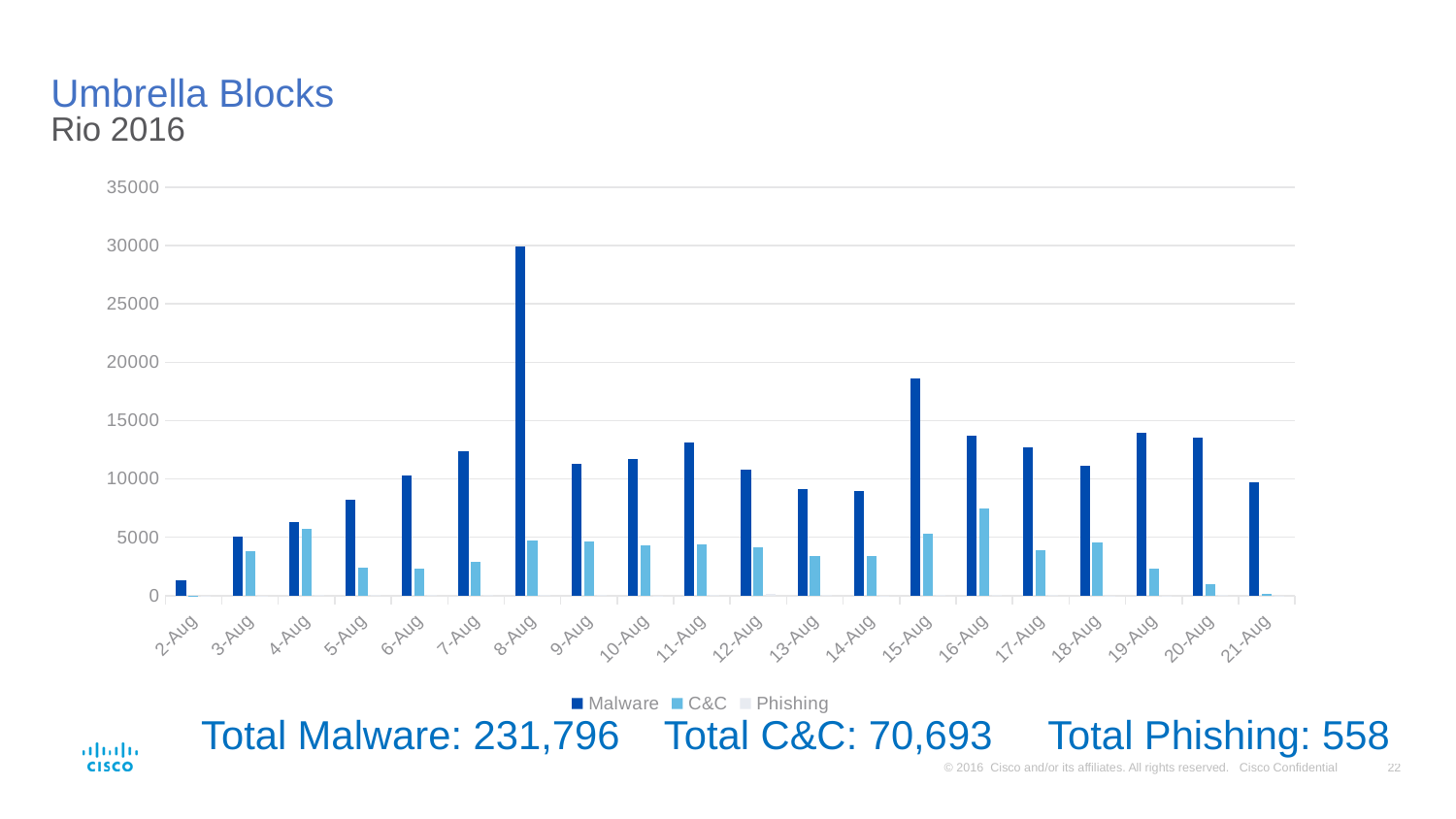
On which date is the C&C value highest? 16-Aug How many series does the legend list? 3 Is the Malware value for 8-Aug greater or less than 25000? greater What total C&C figure is printed on the slide? 70,693 Is the Malware value for 15-Aug greater or less than 15000? greater On which date is the Malware value highest? 8-Aug How many dates are shown along the x axis? 20 Is the C&C value for 16-Aug greater or less than 10000? less What kind of chart is shown on the slide? bar chart What total Malware figure is printed on the slide? 231,796 Which is larger, the Malware value for 15-Aug or the Malware value for 14-Aug? 15-Aug On which date is the Malware value lowest? 2-Aug